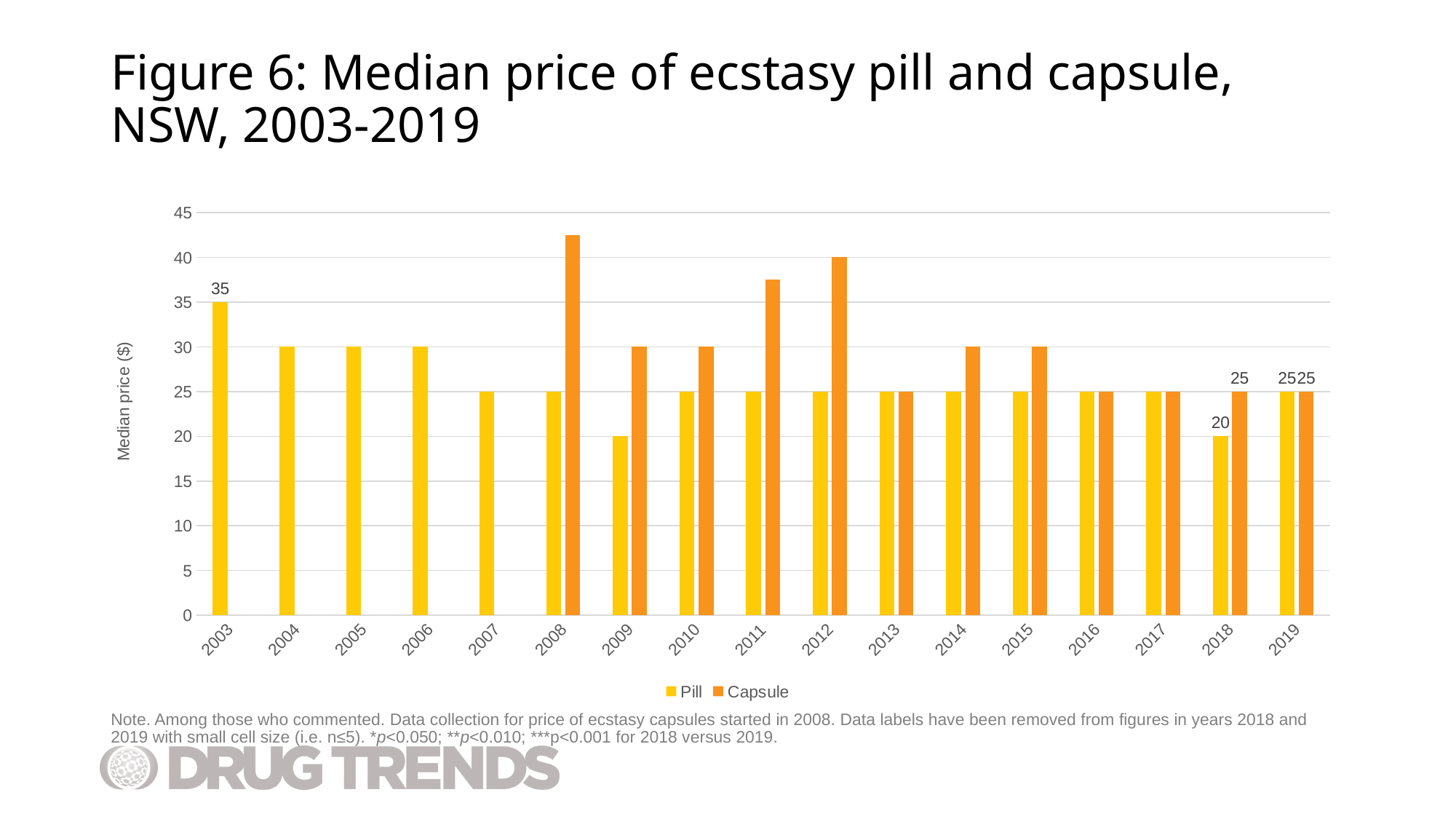
What is the median price of an ecstasy capsule in 2018? 25 What kind of chart is shown on the slide? bar chart In which year is the median pill price highest? 2003 Is the median capsule price in 2008 greater or less than 40? greater How many series does the legend list? 2 What is the median price of an ecstasy pill in 2018? 20 What is the median price of an ecstasy pill in 2003? 35 Which is larger: the median pill price in 2003 or in 2018? 2003 Is the median capsule price in 2011 greater or less than 35? greater What is the difference between the median capsule price and the median pill price in 2018? 5 What is the median price of an ecstasy pill in 2019? 25 In which year is the median capsule price highest? 2008